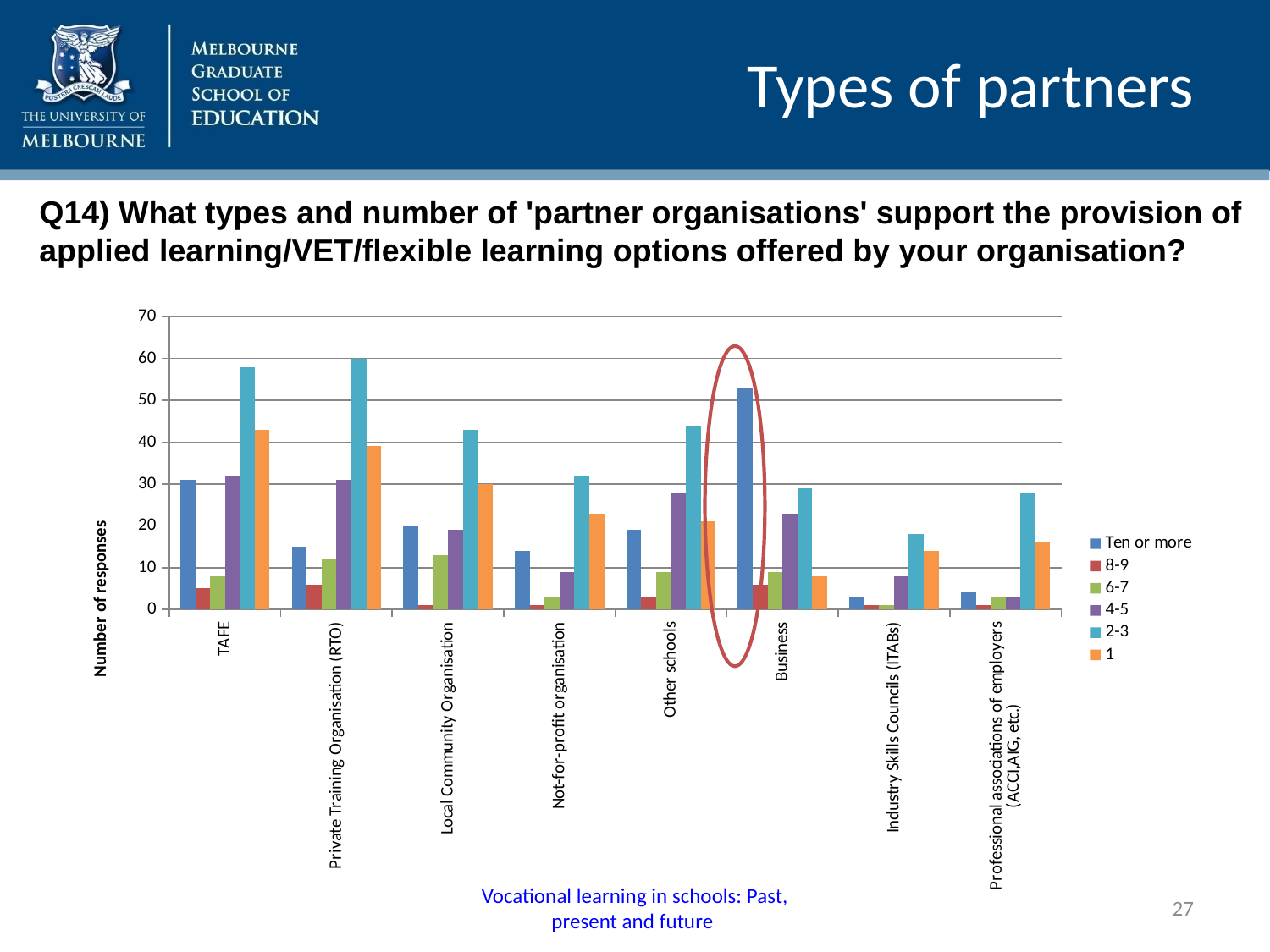
How many partner organisation categories are shown on the x axis of the chart? 8 Which category has the tallest bar for the 'Ten or more' series? Business Which category has the lowest bar for the '2-3' series? Industry Skills Councils (ITABs) For the TAFE category, which series has the larger value: '2-3' or '1'? 2-3 For the Business category, which series has the larger value: 'Ten or more' or '2-3'? Ten or more Is the value for 'Ten or more' in the Industry Skills Councils (ITABs) category greater or less than 10? less Is the value for '1' in the Not-for-profit organisation category greater or less than 20? greater Is the value for '2-3' in the TAFE category greater or less than 50? greater What is the label of the chart's vertical axis? Number of responses What kind of chart is shown on the slide? bar chart How many series does the chart's legend list? 6